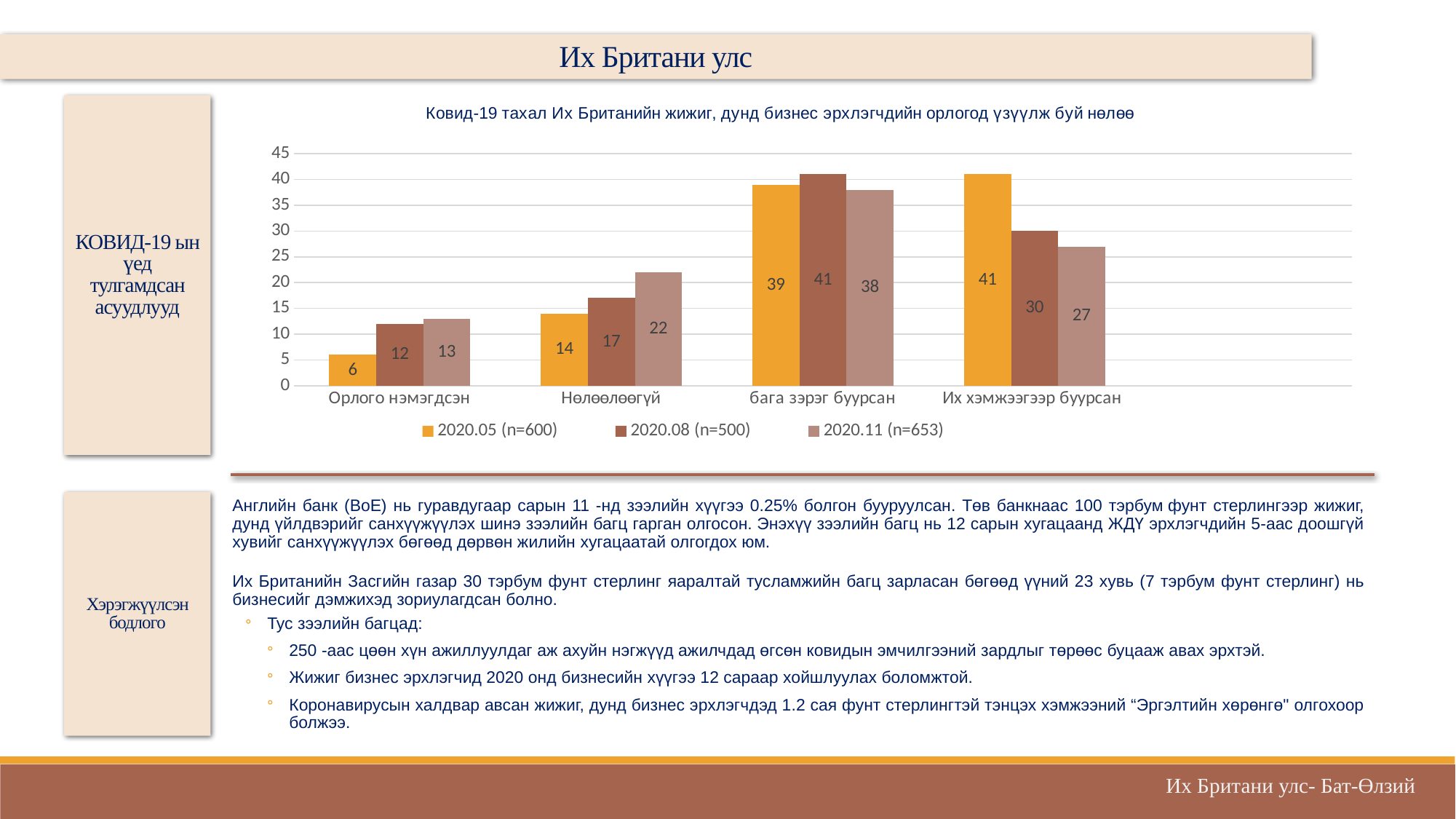
What is the value for 'Их хэмжээгээр буурсан' in the 2020.11 (n=653) series? 27 Which category has the lowest value in the 2020.11 (n=653) series? Орлого нэмэгдсэн What is the value for 'Орлого нэмэгдсэн' in the 2020.05 (n=600) series? 6 Which is larger for 'Нөлөөлөөгүй': the 2020.05 (n=600) value or the 2020.08 (n=500) value? 2020.08 (n=500) How many series does the chart legend list? 3 How many categories are shown on the x axis of the chart? 4 What is the value for 'Нөлөөлөөгүй' in the 2020.11 (n=653) series? 22 What is the difference between the 2020.05 (n=600) and 2020.11 (n=653) values for 'Их хэмжээгээр буурсан'? 14 What is the value for 'бага зэрэг буурсан' in the 2020.08 (n=500) series? 41 Which category has the highest value in the 2020.05 (n=600) series? Их хэмжээгээр буурсан Is the 2020.08 (n=500) value for 'Их хэмжээгээр буурсан' greater or less than 25? greater What type of chart is shown on the slide? Bar chart